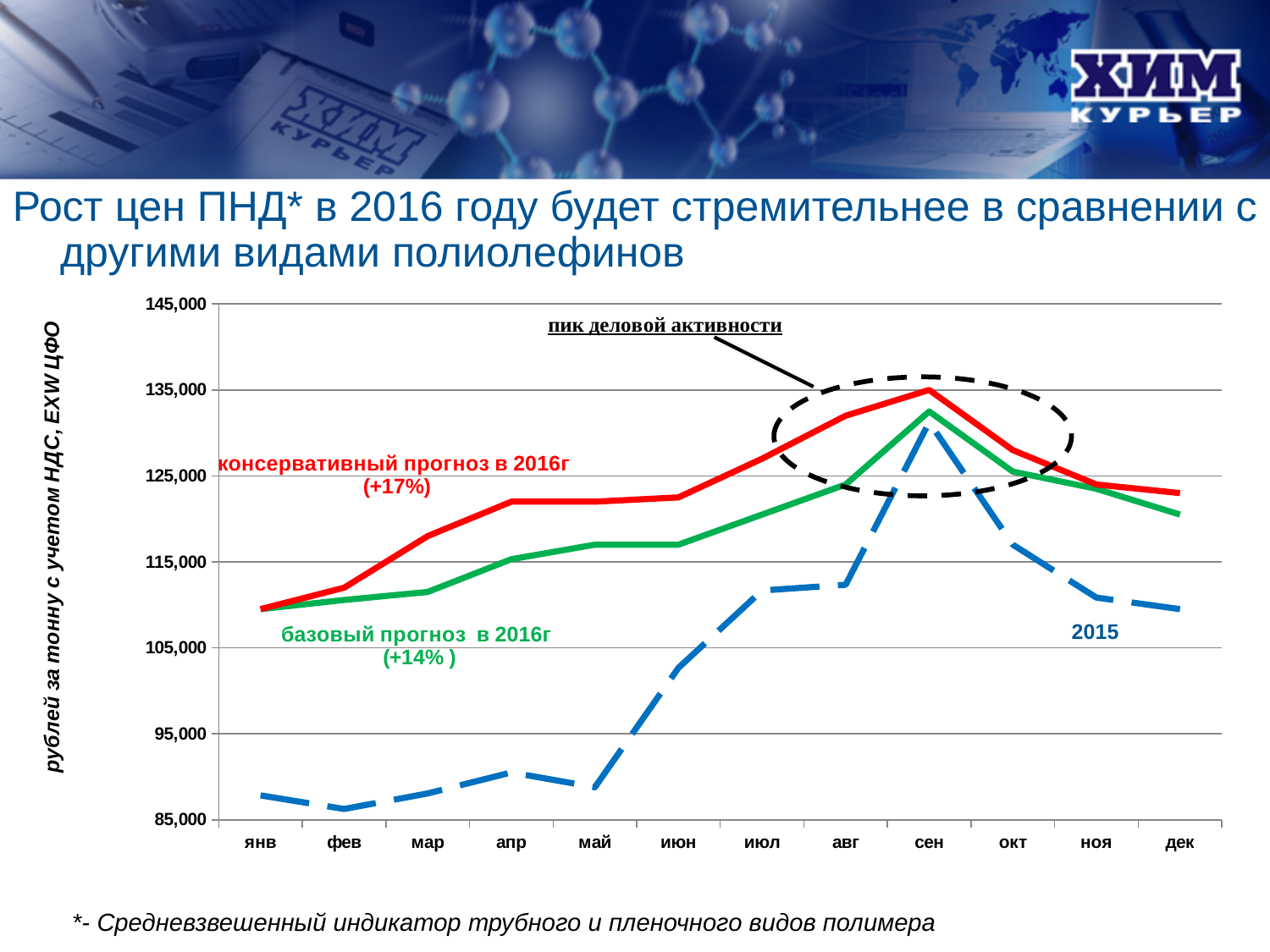
How many lines (series) are plotted on the chart? 3 Is the conservative forecast (консервативный прогноз) value for апр greater or less than 115,000? greater How many months are shown along the x axis? 12 Is the base forecast (базовый прогноз) value for июн greater or less than 125,000? less What percentage growth is indicated for the conservative forecast in 2016? +17% Does the 2015 line rise or fall from янв to сен? rise In which month does the conservative forecast for 2016 (консервативный прогноз) reach its highest value? сен In which month does the 2015 line reach its highest value? сен Is the 2015 value for дек greater or less than 105,000? greater In авг, which line is higher: the conservative forecast or the base forecast for 2016? консервативный прогноз What type of chart is shown on the slide? line chart